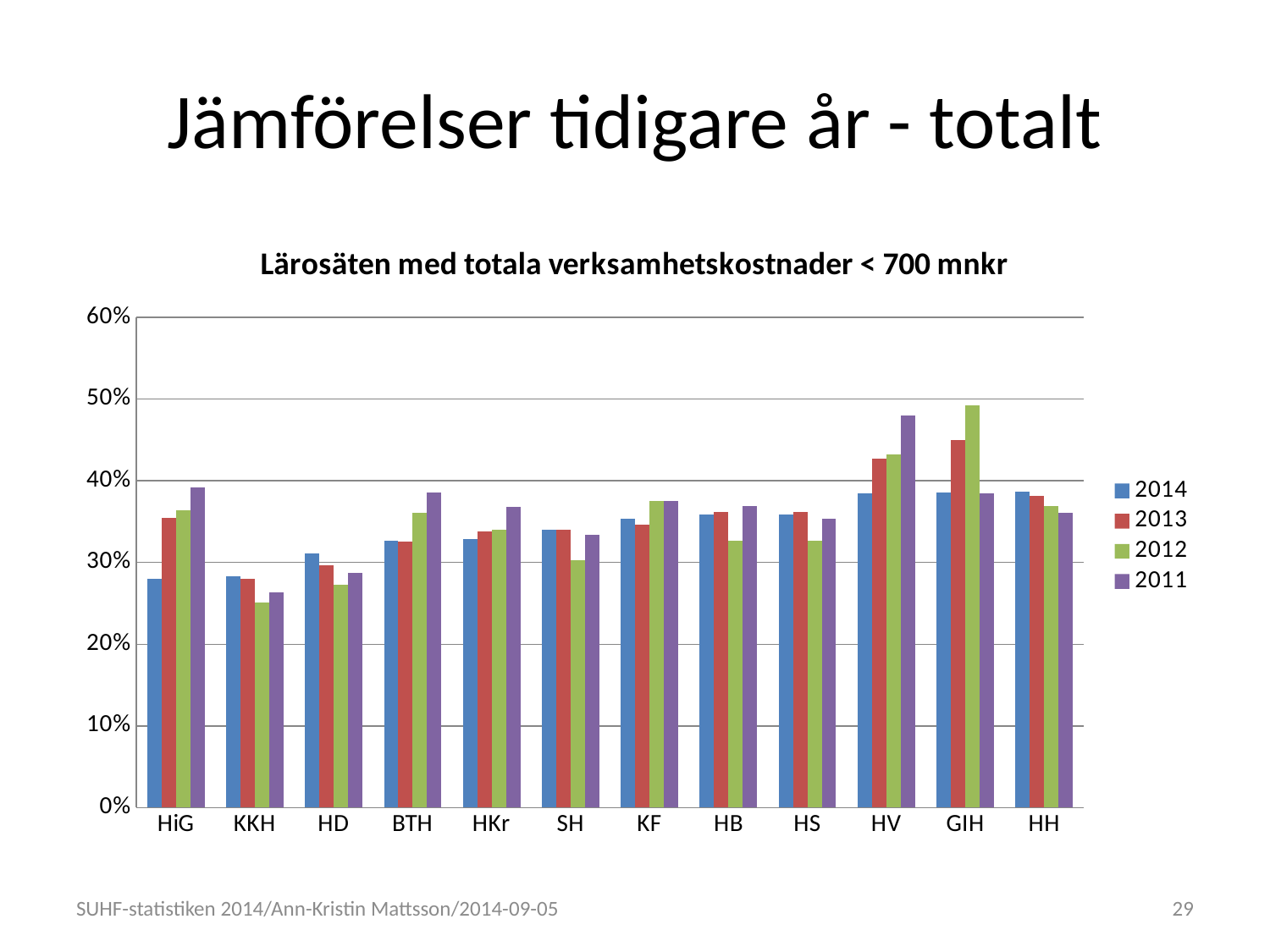
Which category has the highest bar in the 2011 series? HV Which category has the lowest bar in the 2012 series? KKH How many series does the legend list? 4 Is the 2014 value for HiG greater or less than 30%? less How many categories (institutions) are shown on the x axis? 12 What kind of chart is shown on the slide? bar chart What is the title of the chart? Lärosäten med totala verksamhetskostnader < 700 mnkr Which category has the highest bar in the 2012 series? GIH Is the 2012 value for KKH greater or less than 30%? less Is the 2011 value for HV greater or less than 40%? greater Which years are listed in the legend? 2014, 2013, 2012, 2011 For GIH, which is larger, the 2012 value or the 2014 value? 2012